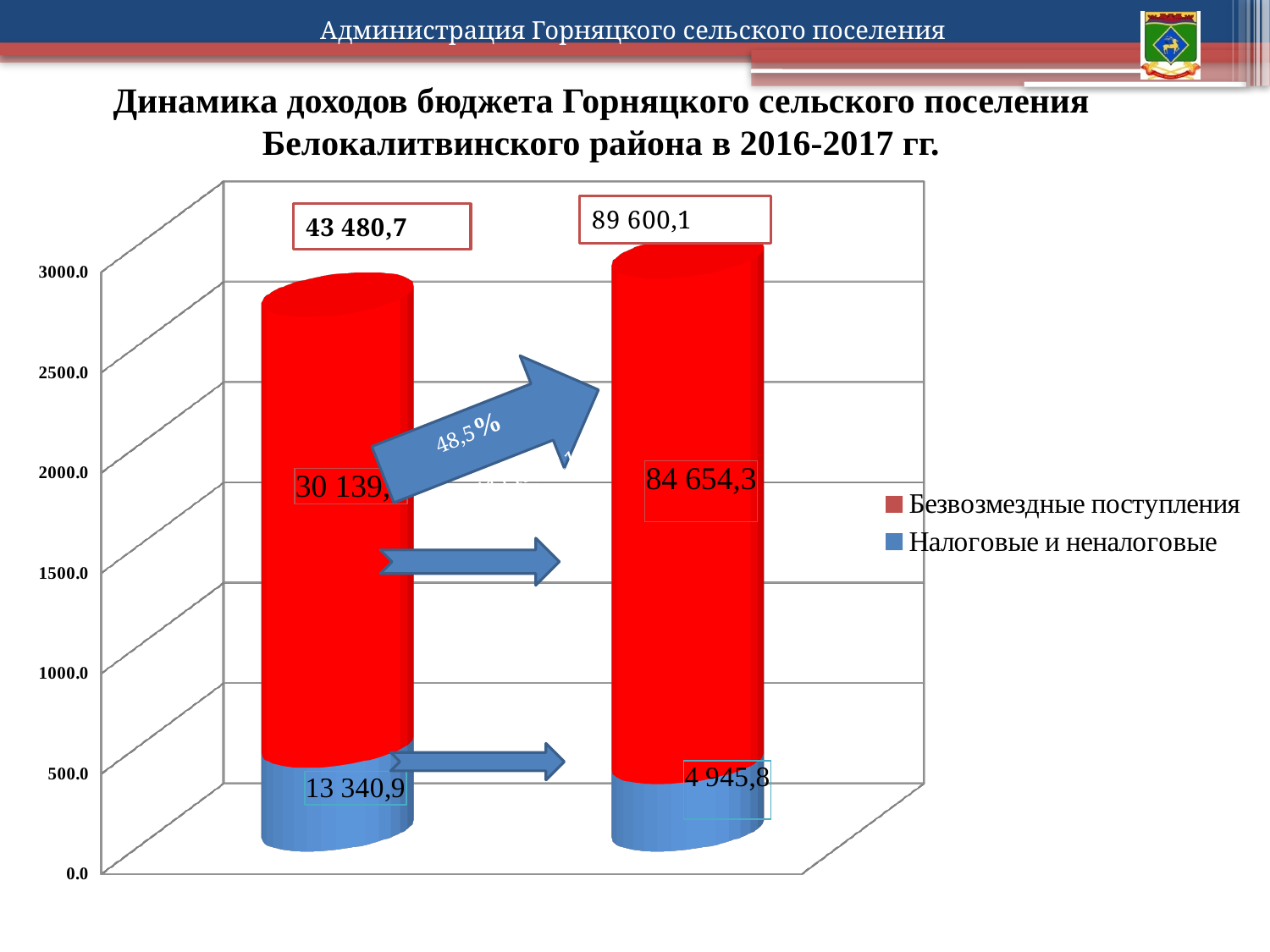
How many stacked bars are plotted in the chart? 2 In the right bar, how much larger is "Безвозмездные поступления" than "Налоговые и неналоговые"? 79 708,5 What is the value of "Безвозмездные поступления" for the right bar? 84 654,3 What colour represents "Безвозмездные поступления" in the chart? red Does the total of the bars rise or fall from the left bar to the right bar? rises What is the value of "Налоговые и неналоговые" for the right bar? 4 945,8 What is the total shown above the left bar? 43 480,7 What is the total shown above the right bar? 89 600,1 What kind of chart is shown on the slide? bar chart How many series does the legend list? 2 Which bar has the larger value for "Налоговые и неналоговые", the left or the right? left What is the value of "Налоговые и неналоговые" for the left bar? 13 340,9